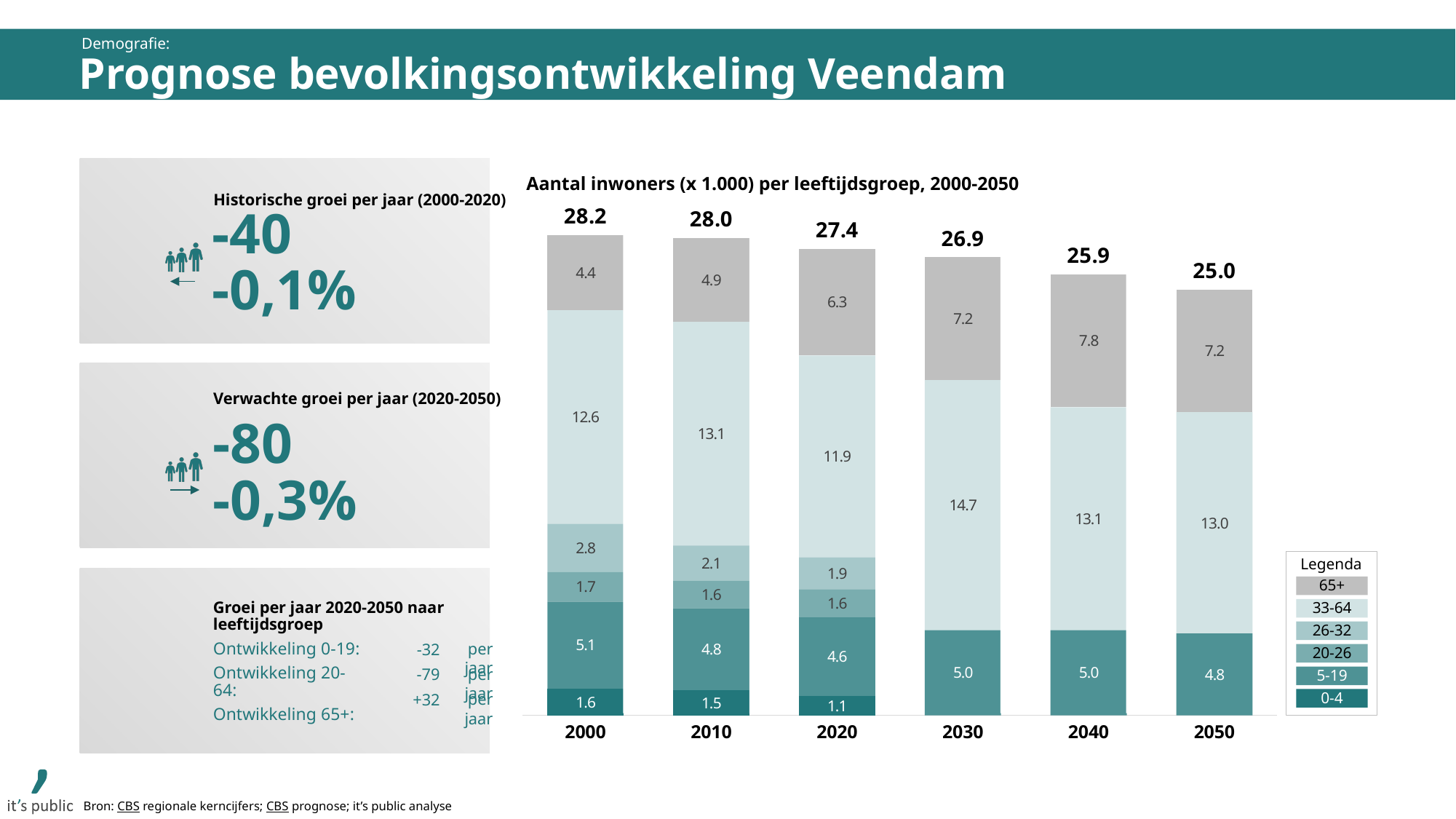
Which year has the larger value for the 33-64 age group, 2010 or 2020? 2010 What is the value for the 0-4 age group in 2020? 1.1 Which year has the lowest total number of inhabitants? 2050 What is the total number of inhabitants (x 1.000) shown for 2000? 28.2 Which year has the highest total number of inhabitants? 2000 What is the value for the 33-64 age group in 2030? 14.7 What is the value for the 65+ age group in 2020? 6.3 What kind of chart is shown on the slide? stacked bar chart By how much does the 65+ value in 2040 exceed the 65+ value in 2000? 3.4 How many years are shown along the x axis? 6 How many age groups does the legend list? 6 Do the total values rise or fall from 2000 to 2050? fall